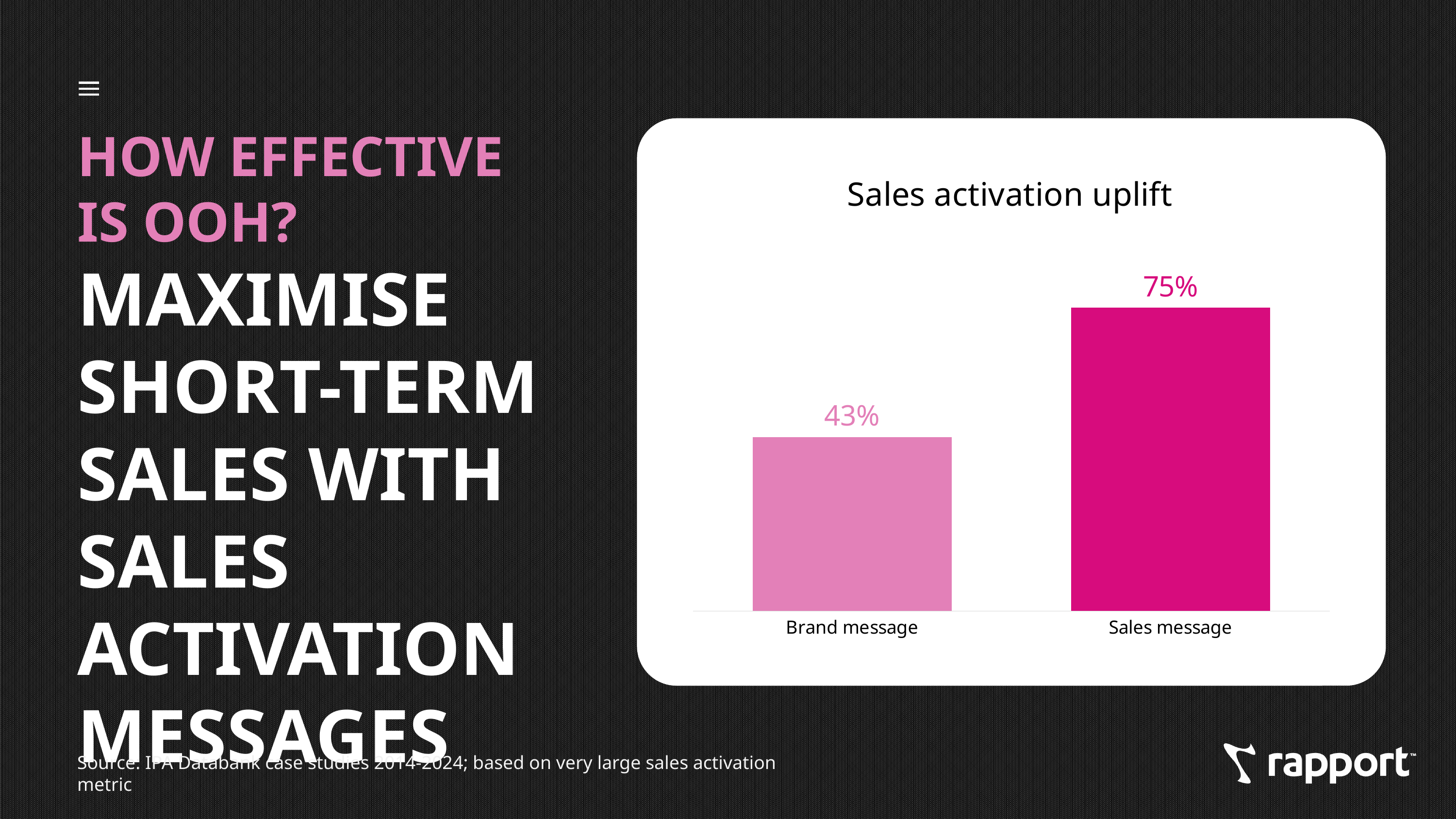
Which bar is drawn in the darker pink colour? Sales message Which category has the lowest sales activation uplift? Brand message What is the sales activation uplift for Sales message? 75% Which has a larger sales activation uplift, Brand message or Sales message? Sales message What is the title of the chart? Sales activation uplift How many categories are shown in the chart? 2 What is the sales activation uplift for Brand message? 43% What kind of chart is shown on the slide? Bar chart What is the difference in sales activation uplift between Sales message and Brand message? 32% Which category has the highest sales activation uplift? Sales message